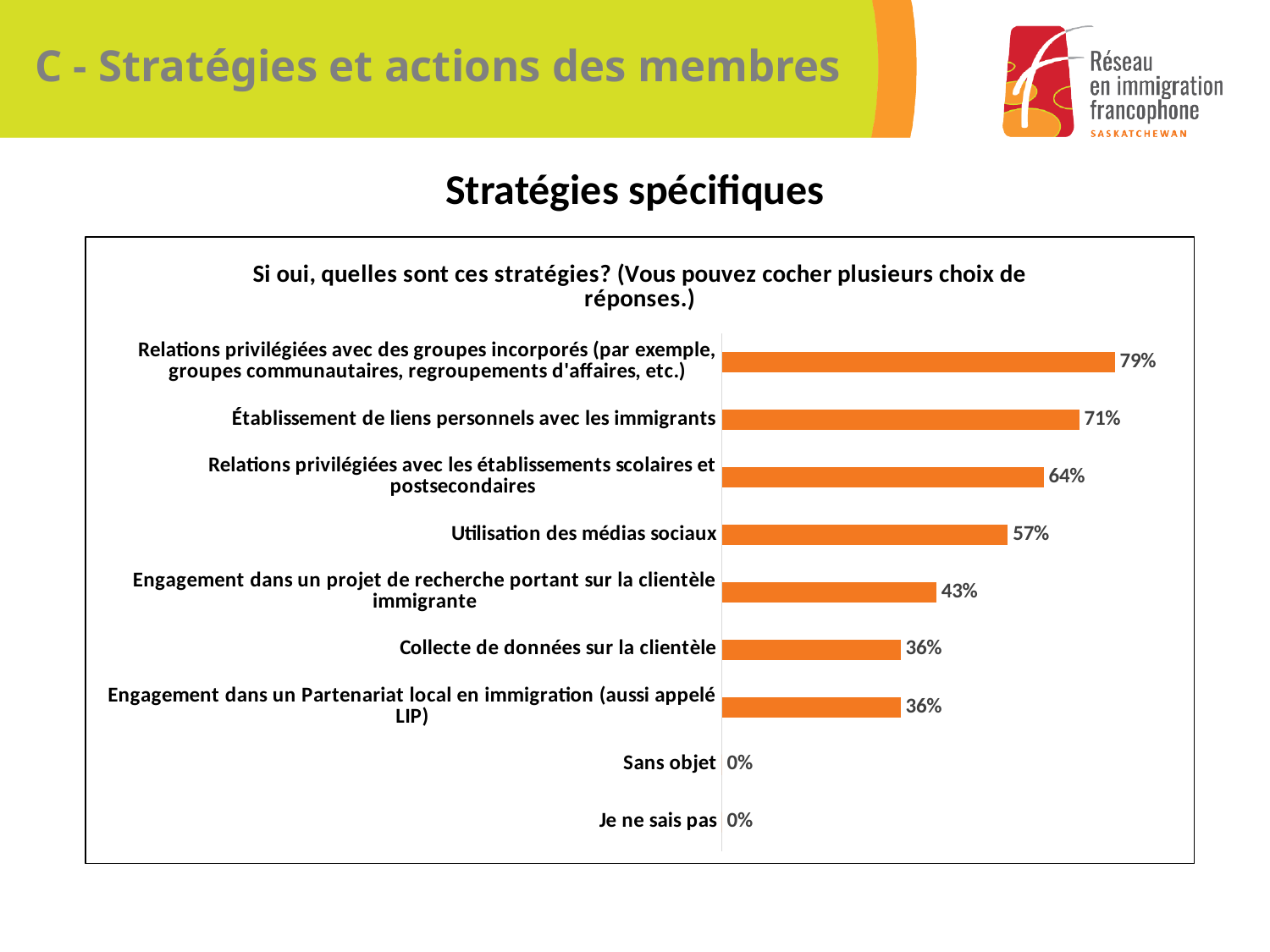
What percentage is shown for "Sans objet"? 0% What colour are the bars in the chart? Orange Which is larger: the value for "Relations privilégiées avec les établissements scolaires et postsecondaires" or the value for "Engagement dans un projet de recherche portant sur la clientèle immigrante"? Relations privilégiées avec les établissements scolaires et postsecondaires What is the difference between the values for "Relations privilégiées avec des groupes incorporés" and "Utilisation des médias sociaux"? 22% What percentage is shown for "Utilisation des médias sociaux"? 57% What is the value for "Engagement dans un projet de recherche portant sur la clientèle immigrante"? 43% What is the difference between the values for "Établissement de liens personnels avec les immigrants" and "Collecte de données sur la clientèle"? 35% How many categories are shown in the chart? 9 What type of chart is shown on the slide? Bar chart Which strategy has the highest percentage? Relations privilégiées avec des groupes incorporés (par exemple, groupes communautaires, regroupements d'affaires, etc.) What percentage is shown for "Collecte de données sur la clientèle"? 36% What is the value for "Établissement de liens personnels avec les immigrants"? 71%